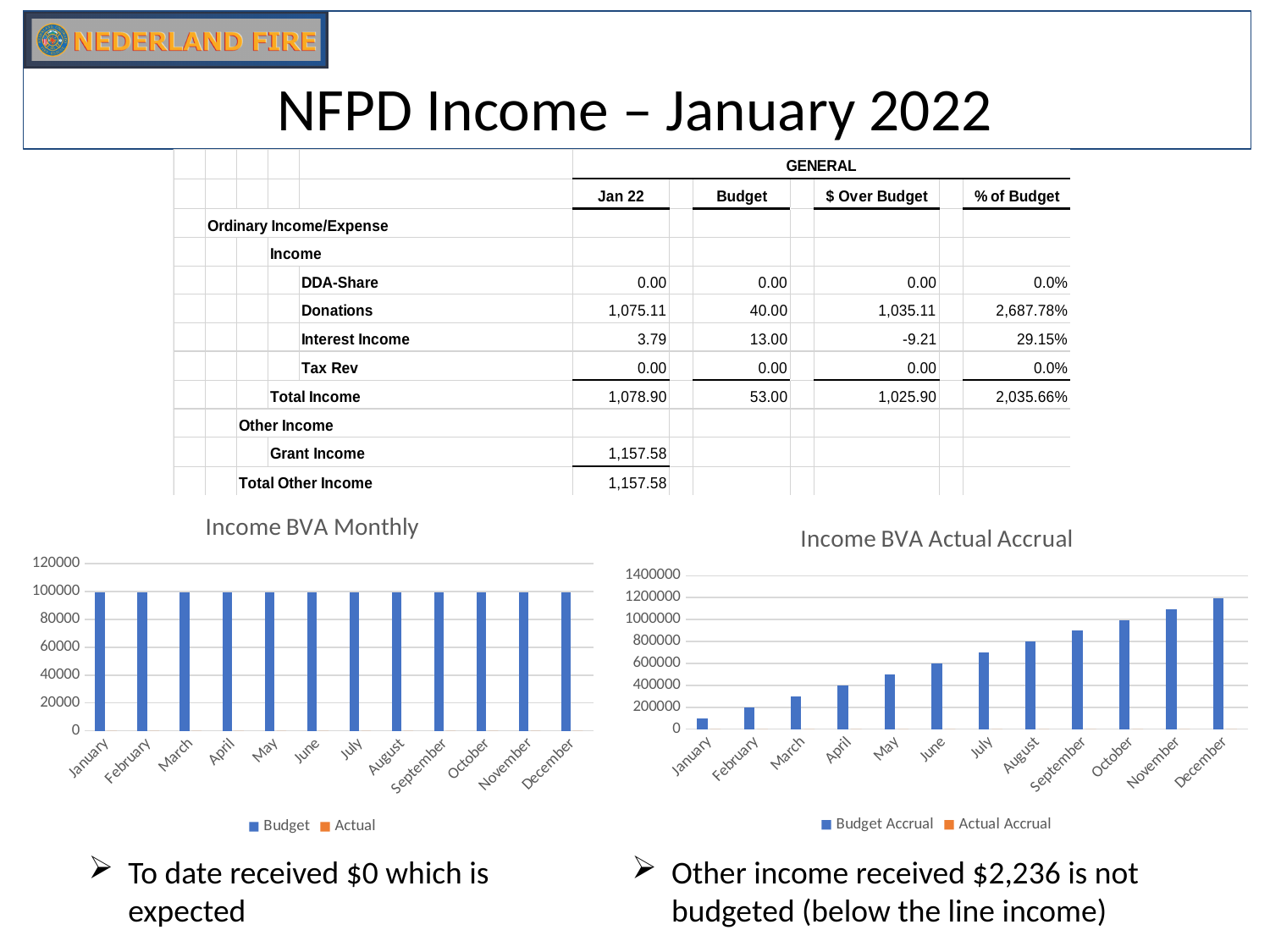
What kind of chart is the Income BVA Actual Accrual chart? bar chart In the Income BVA Actual Accrual chart, do the Budget Accrual values rise or fall from January to December? rise In the Income BVA Actual Accrual chart, is the Budget Accrual value for December greater or less than 1000000? greater How many series does the legend of the Income BVA Monthly chart list? 2 In the Income BVA Monthly chart, is the Budget value for January greater or less than 80000? greater In the Income BVA Actual Accrual chart, which month has the highest Budget Accrual value? December What kind of chart is the Income BVA Monthly chart? bar chart How many series does the legend of the Income BVA Actual Accrual chart list? 2 What are the two legend entries of the Income BVA Monthly chart? Budget and Actual How many months are shown on the x axis of the Income BVA Monthly chart? 12 In the Income BVA Monthly chart, do the Budget values rise, fall, or stay roughly flat from January to December? stay roughly flat In the Income BVA Actual Accrual chart, which month has the lowest Budget Accrual value? January